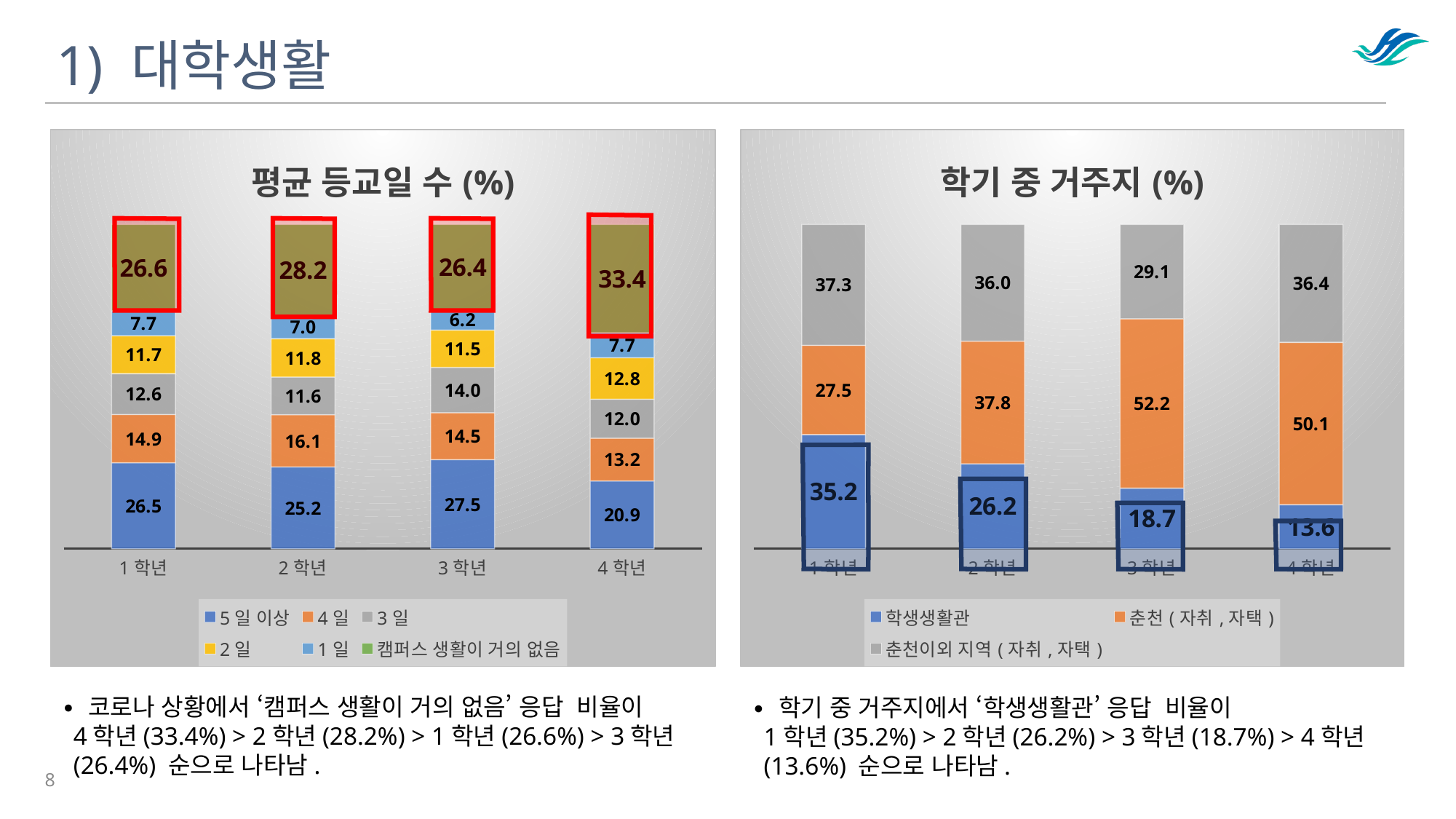
In the '평균 등교일 수 (%)' chart, what is the difference between the '4 일' values for 2 학년 and 4 학년? 2.9 In the '학기 중 거주지 (%)' chart, what is the value of '춘천 ( 자취 , 자택 )' for 3 학년? 52.2 In the '학기 중 거주지 (%)' chart, which grade has the lowest '학생생활관' value? 4 학년 In the '평균 등교일 수 (%)' chart, what is the value of '5 일 이상' for 3 학년? 27.5 What kind of chart is the '학기 중 거주지 (%)' chart? Stacked bar chart In the '학기 중 거주지 (%)' chart, what is the difference between the '학생생활관' values for 1 학년 and 4 학년? 21.6 In the '학기 중 거주지 (%)' chart, is the '춘천이외 지역 ( 자취 , 자택 )' value larger for 1 학년 or 3 학년? 1 학년 In the '평균 등교일 수 (%)' chart, which grade has the lowest '5 일 이상' value? 4 학년 In the '학기 중 거주지 (%)' chart, what is the value of '학생생활관' for 2 학년? 26.2 In the '평균 등교일 수 (%)' chart, what is the value of '캠퍼스 생활이 거의 없음' for 4 학년? 33.4 In the '평균 등교일 수 (%)' chart, which grade has the highest '캠퍼스 생활이 거의 없음' value? 4 학년 How many series does the legend of the '평균 등교일 수 (%)' chart list? 6